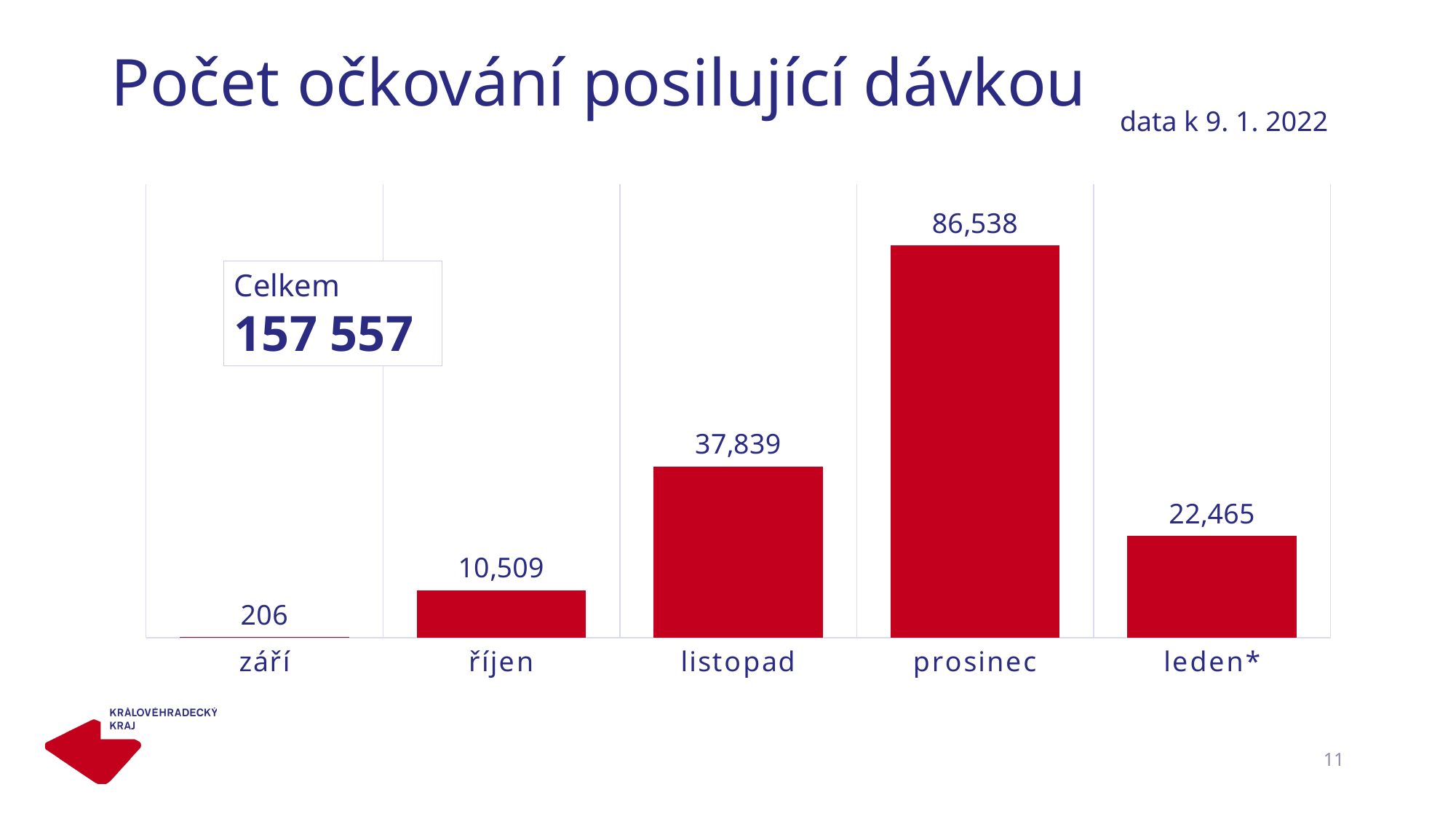
What is the value for prosinec? 86,538 What is the difference between the values for leden* and říjen? 11,956 Which month has the lowest value? září Which is larger, the value for listopad or the value for leden*? listopad What is the difference between the values for prosinec and listopad? 48,699 What is the value for říjen? 10,509 What is the value for leden*? 22,465 How many months are shown on the x axis? 5 What kind of chart is shown on the slide? bar chart Which month has the highest value? prosinec What is the value for září? 206 Do the values rise or fall from září to prosinec? rise